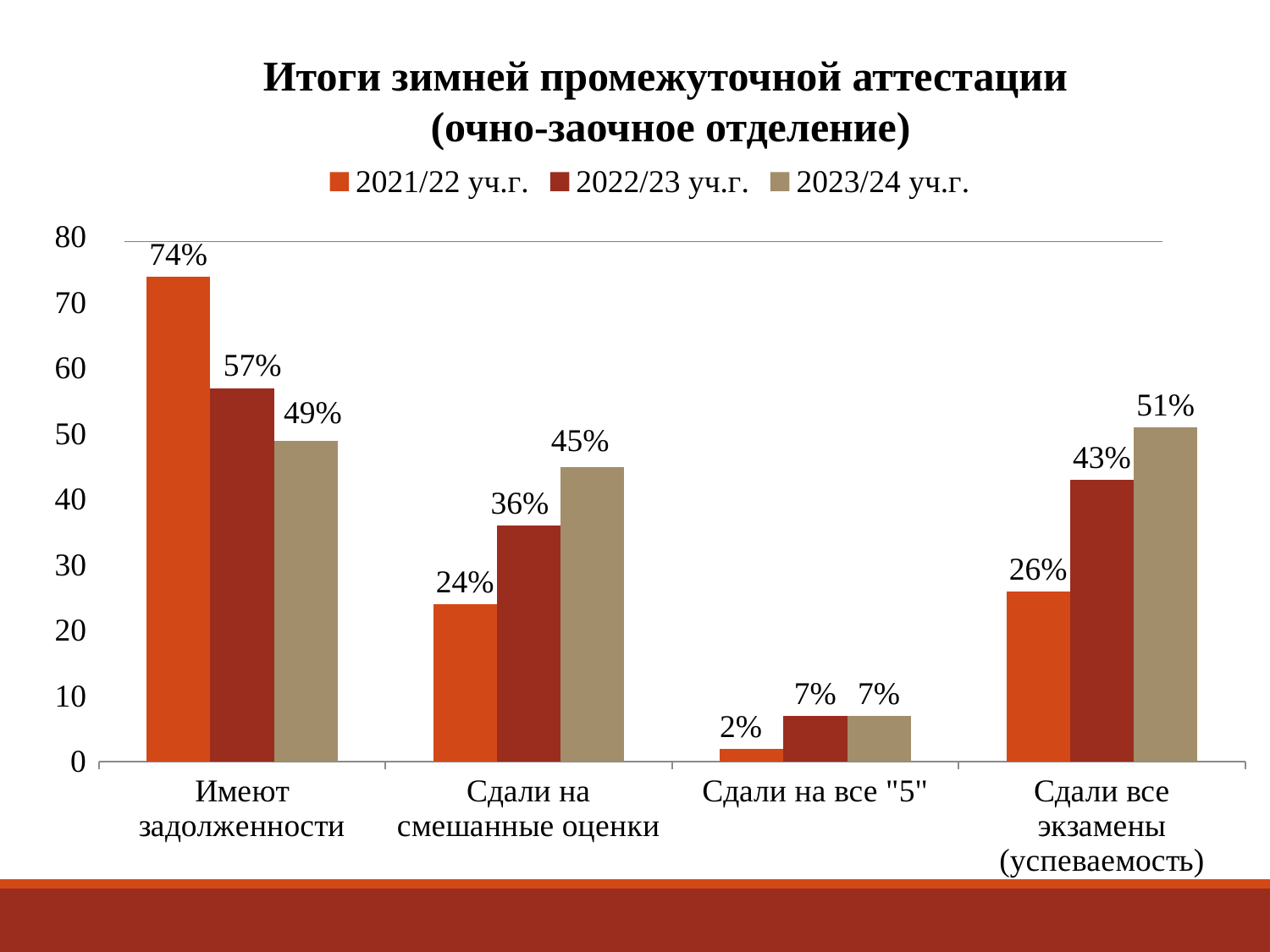
What is the value for 2023/24 уч.г. in the category "Сдали все экзамены (успеваемость)"? 51% Do the values for "Имеют задолженности" rise or fall from 2021/22 уч.г. to 2023/24 уч.г.? Fall What is the title of the chart? Итоги зимней промежуточной аттестации (очно-заочное отделение) How many series does the legend list? 3 How many categories are shown on the x axis? 4 Which category has the highest value for 2021/22 уч.г.? Имеют задолженности Which category has the lowest value for 2023/24 уч.г.? Сдали на все "5" What is the difference between the 2021/22 уч.г. and 2023/24 уч.г. values for "Имеют задолженности"? 25% Which is larger for "Сдали все экзамены (успеваемость)": the 2021/22 уч.г. value or the 2022/23 уч.г. value? 2022/23 уч.г. What is the value for 2021/22 уч.г. in the category "Имеют задолженности"? 74% What kind of chart is shown on the slide? Bar chart What is the value for 2022/23 уч.г. in the category "Сдали на смешанные оценки"? 36%